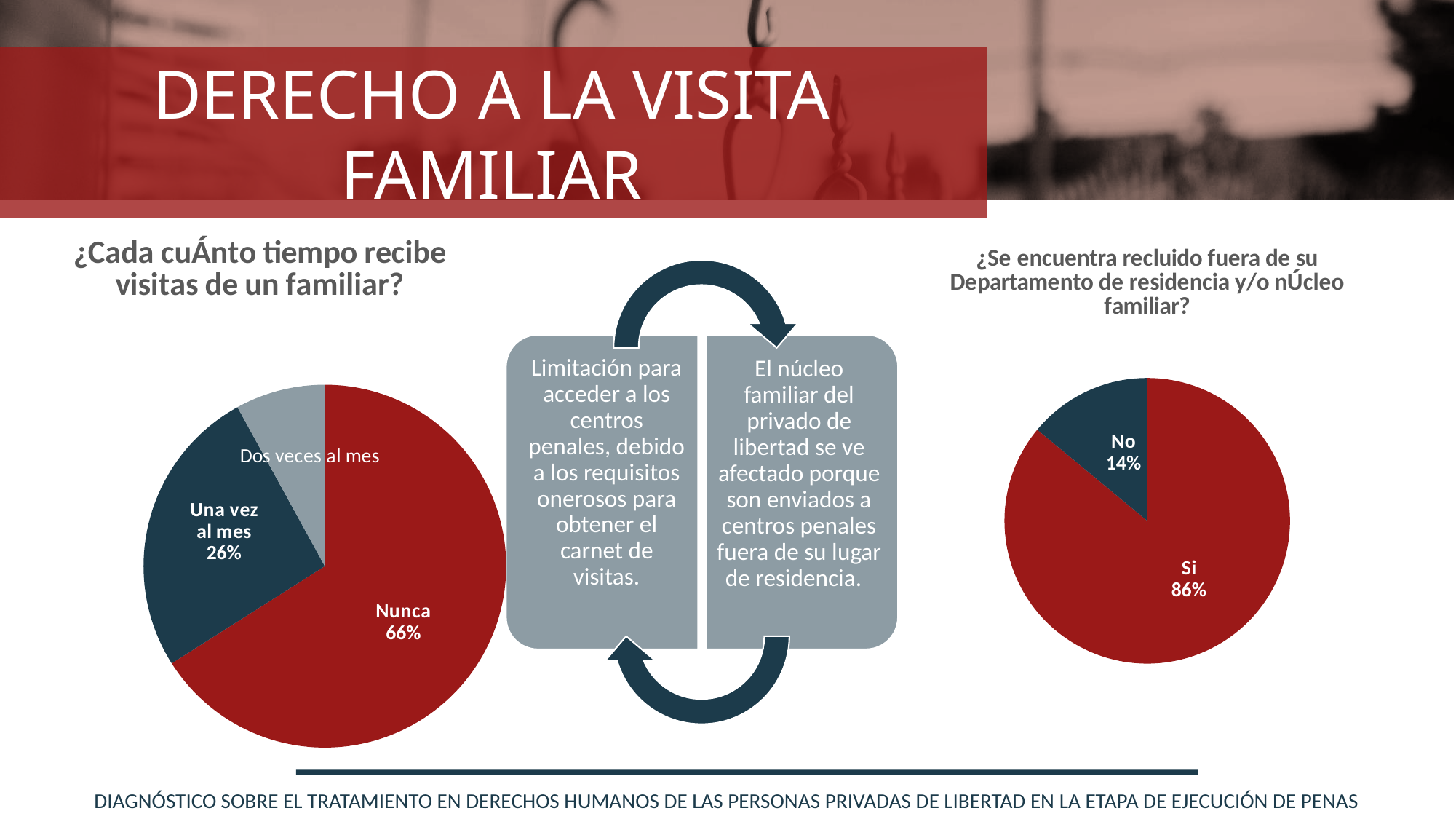
In the right pie chart (¿Se encuentra recluido fuera de su Departamento de residencia y/o núcleo familiar?), what share is labelled for 'No'? 14% In the right pie chart (¿Se encuentra recluido fuera de su Departamento de residencia y/o núcleo familiar?), what share is labelled for 'Si'? 86% How many slices does the left pie chart (¿Cada cuánto tiempo recibe visitas de un familiar?) have? 3 In the left pie chart (¿Cada cuánto tiempo recibe visitas de un familiar?), what share is labelled for 'Nunca'? 66% In the left pie chart (¿Cada cuánto tiempo recibe visitas de un familiar?), which category has the smallest slice? Dos veces al mes What type of chart is used for the right chart (¿Se encuentra recluido fuera de su Departamento de residencia y/o núcleo familiar?)? Pie chart In the left pie chart (¿Cada cuánto tiempo recibe visitas de un familiar?), what colour is the 'Nunca' slice? Red In the right pie chart (¿Se encuentra recluido fuera de su Departamento de residencia y/o núcleo familiar?), which is larger, 'Si' or 'No'? Si In the left pie chart (¿Cada cuánto tiempo recibe visitas de un familiar?), what is the difference in percentage points between 'Nunca' and 'Una vez al mes'? 40 In the left pie chart (¿Cada cuánto tiempo recibe visitas de un familiar?), what share is labelled for 'Una vez al mes'? 26% In the left pie chart (¿Cada cuánto tiempo recibe visitas de un familiar?), which category has the largest slice? Nunca In the right pie chart (¿Se encuentra recluido fuera de su Departamento de residencia y/o núcleo familiar?), what is the difference in percentage points between 'Si' and 'No'? 72